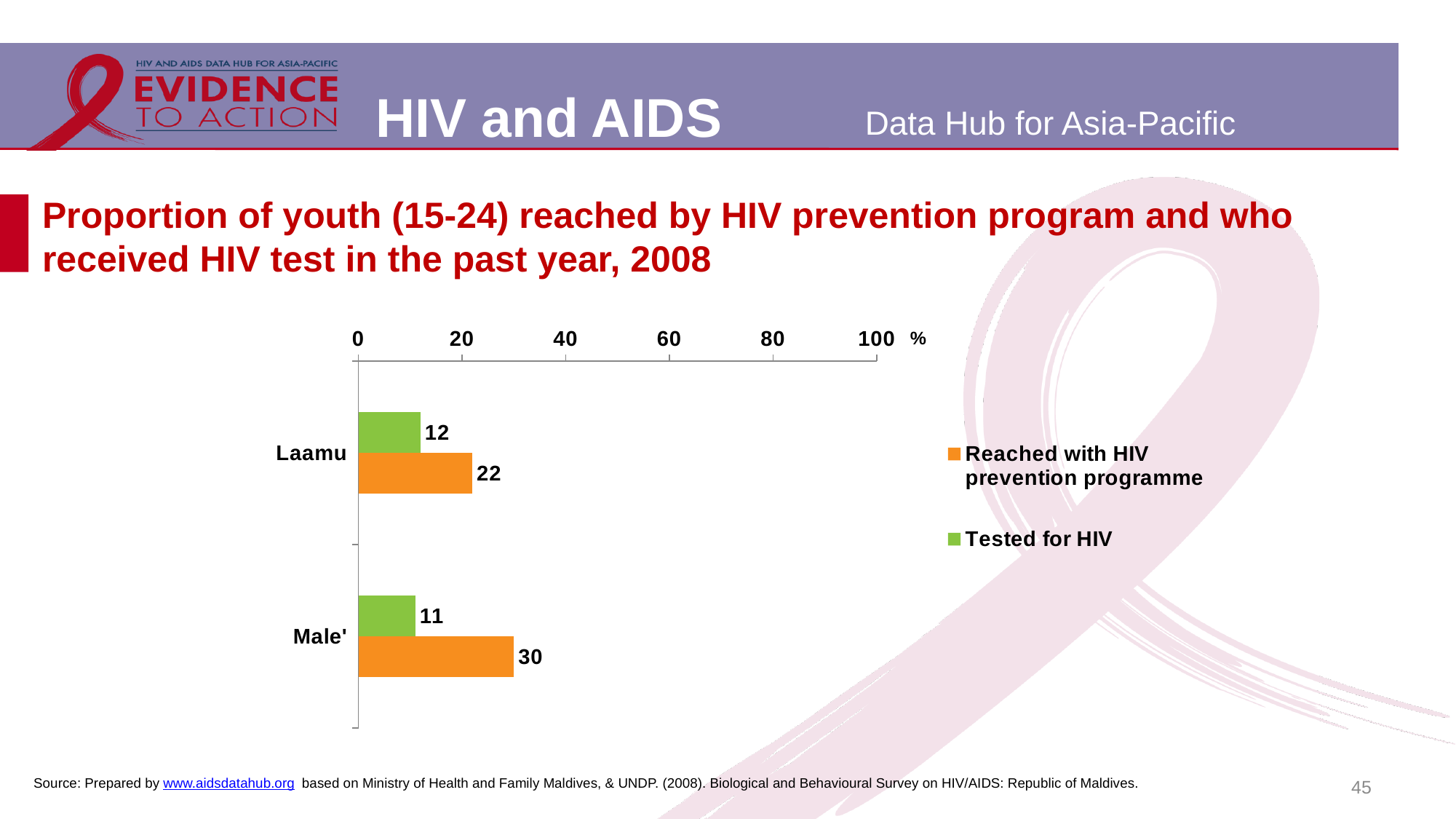
How many series does the legend list? 2 Which colour represents 'Tested for HIV' in the chart? Green What percentage of youth in Laamu were reached with the HIV prevention programme? 22 How many locations are shown on the chart? 2 Which location has the higher value for 'Reached with HIV prevention programme'? Male' What type of chart is shown on the slide? Bar chart In Male', what is the difference between the proportion reached with the HIV prevention programme and the proportion tested for HIV? 19 Is the 'Reached with HIV prevention programme' value for Male' greater or less than 20? greater What percentage of youth in Laamu were tested for HIV? 12 What percentage of youth in Male' were tested for HIV? 11 What is the difference between the 'Reached with HIV prevention programme' values for Male' and Laamu? 8 What percentage of youth in Male' were reached with the HIV prevention programme? 30